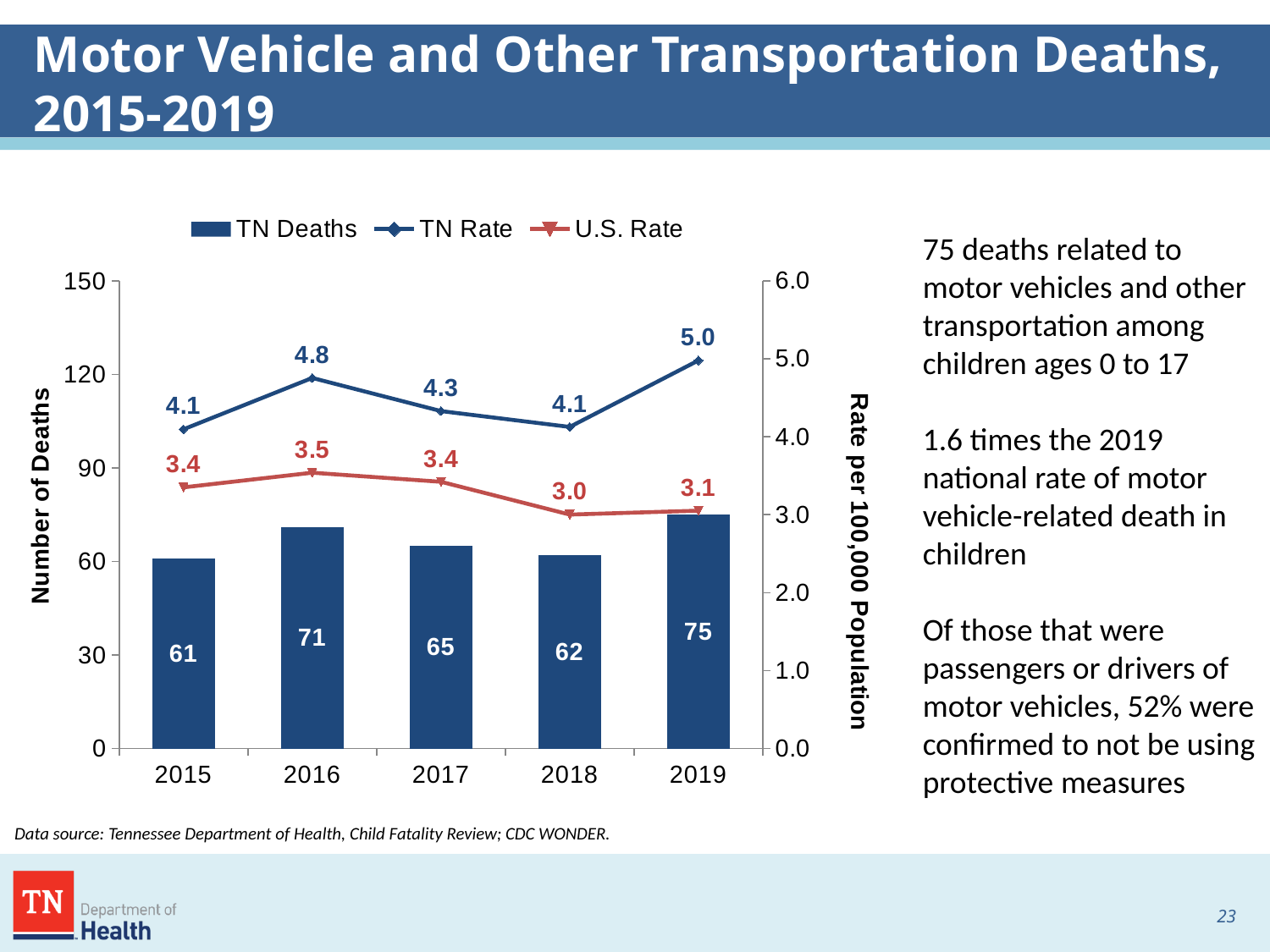
Which year had the highest number of TN Deaths? 2019 What was the TN Rate in 2019? 5.0 What was the U.S. Rate in 2018? 3.0 How many TN Deaths were there in 2016? 71 How many series does the legend list? 3 What is the difference between the TN Rate and the U.S. Rate in 2019? 1.9 What is the label of the right-hand vertical axis? Rate per 100,000 Population Were there more TN Deaths in 2016 or in 2018? 2016 Which was higher in 2017, the TN Rate or the U.S. Rate? TN Rate How many years are shown on the x axis? 5 What is the difference between TN Deaths in 2019 and 2015? 14 Which year had the lowest TN Rate? 2015 and 2018